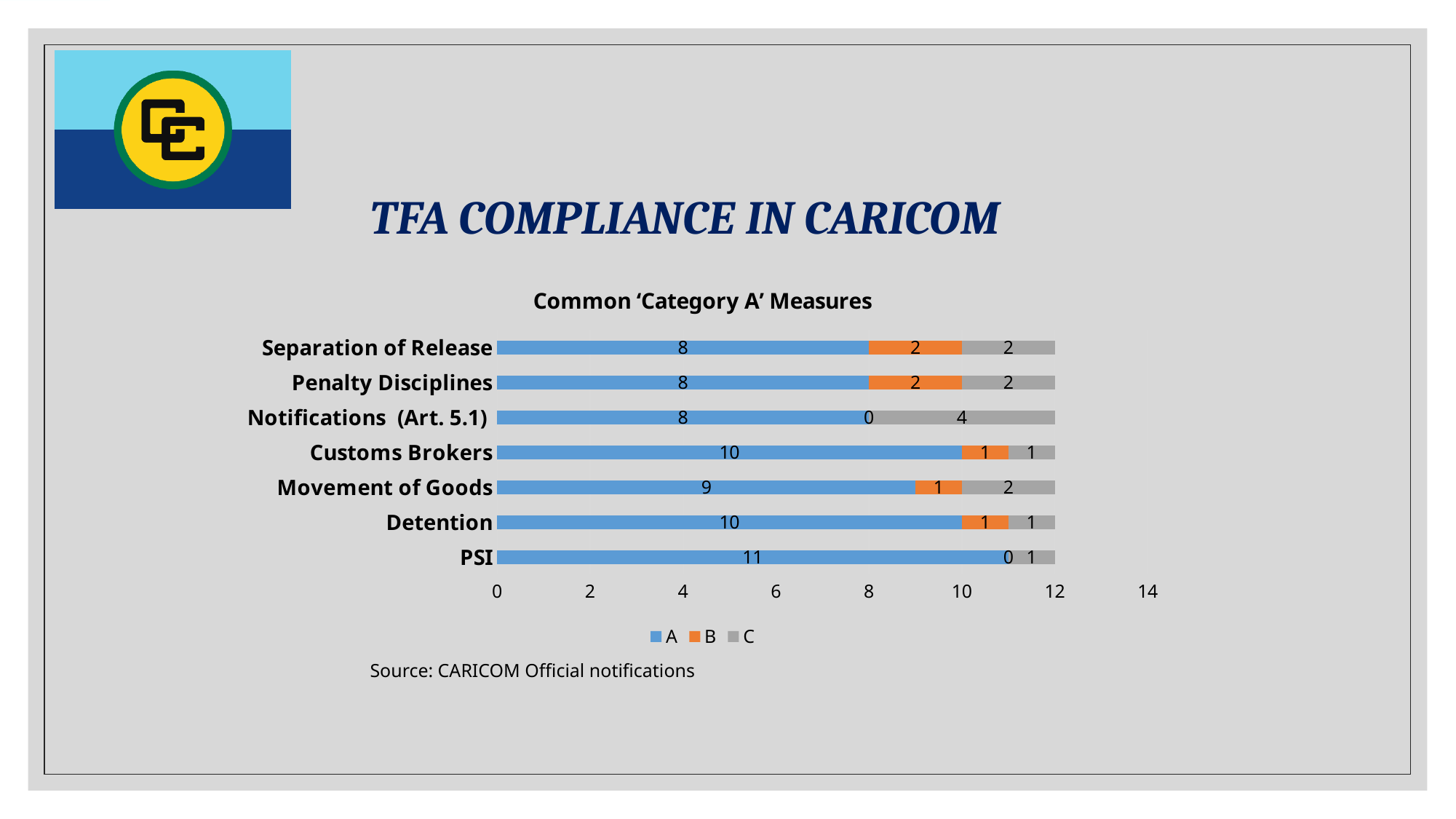
Which category has the highest value for series C? Notifications (Art. 5.1) What is the value of series C for Notifications (Art. 5.1)? 4 What is the total of the stacked bar for Detention? 12 Is the series A value for Customs Brokers larger than the series A value for Movement of Goods? Yes What is the title of the chart? Common ‘Category A’ Measures What is the value of series B for Movement of Goods? 1 How many series does the legend list? 3 What kind of chart is shown? Stacked bar chart Which category has the highest value for series A? PSI What is the difference between the series A values for PSI and Separation of Release? 3 How many categories are shown on the chart? 7 What is the value of series A for PSI? 11